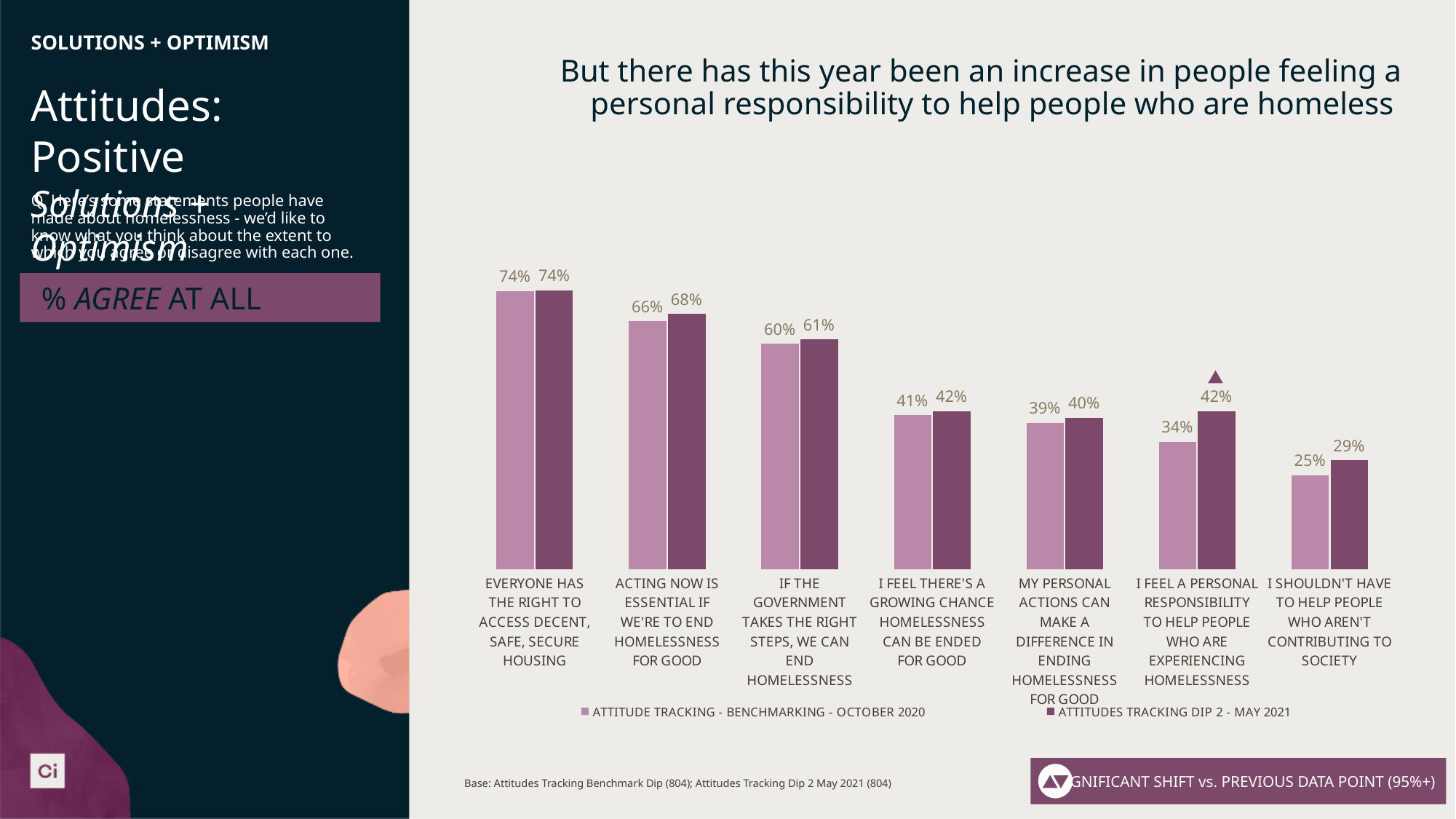
What is the difference between the May 2021 and October 2020 values for "I shouldn't have to help people who aren't contributing to society"? 4 percentage points How many series does the legend list? 2 What percentage agreed with "I shouldn't have to help people who aren't contributing to society" in October 2020? 25% What kind of chart is shown on the slide? Bar chart Which statement has the highest level of agreement in the May 2021 series? Everyone has the right to access decent, safe, secure housing What percentage agreed with "I feel a personal responsibility to help people who are experiencing homelessness" in the Attitudes Tracking Dip 2 - May 2021 series? 42% Which statement has the lowest level of agreement in the October 2020 series? I shouldn't have to help people who aren't contributing to society What percentage agreed with "Everyone has the right to access decent, safe, secure housing" in the Attitude Tracking - Benchmarking - October 2020 series? 74% Which is larger for "Acting now is essential if we're to end homelessness for good": the October 2020 value or the May 2021 value? May 2021 What is the difference between the May 2021 and October 2020 values for "I feel a personal responsibility to help people who are experiencing homelessness"? 8 percentage points How many statements (categories) are shown on the chart? 7 Which statement is marked with a triangle indicating a significant shift vs. the previous data point? I feel a personal responsibility to help people who are experiencing homelessness